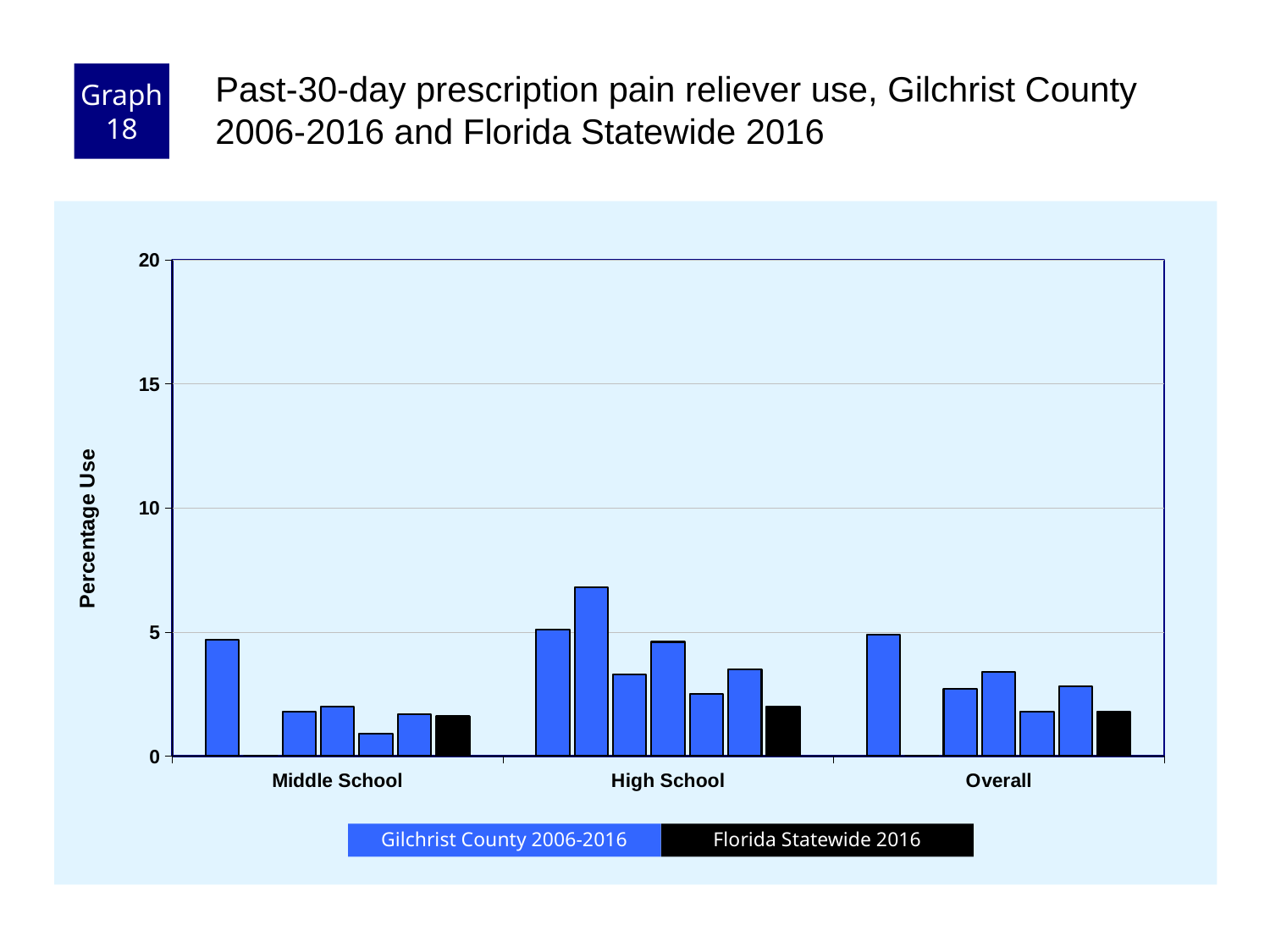
Which category contains the tallest bar in the chart? High School Which is larger: the first Gilchrist County bar in the Middle School category or the Florida Statewide 2016 bar in the Middle School category? the first Gilchrist County bar What is the title of the y axis? Percentage Use What kind of chart is shown on the slide? bar chart Is any bar in the chart greater than 10? no Which is larger: the Florida Statewide 2016 bar for High School or the tallest Gilchrist County bar for High School? the tallest Gilchrist County bar Is the Florida Statewide 2016 value for High School greater or less than 5? less How many series does the legend list? 2 Is the Florida Statewide 2016 value for Overall greater or less than 5? less How many categories are shown on the x axis? 3 Which colour represents the Florida Statewide 2016 series? black